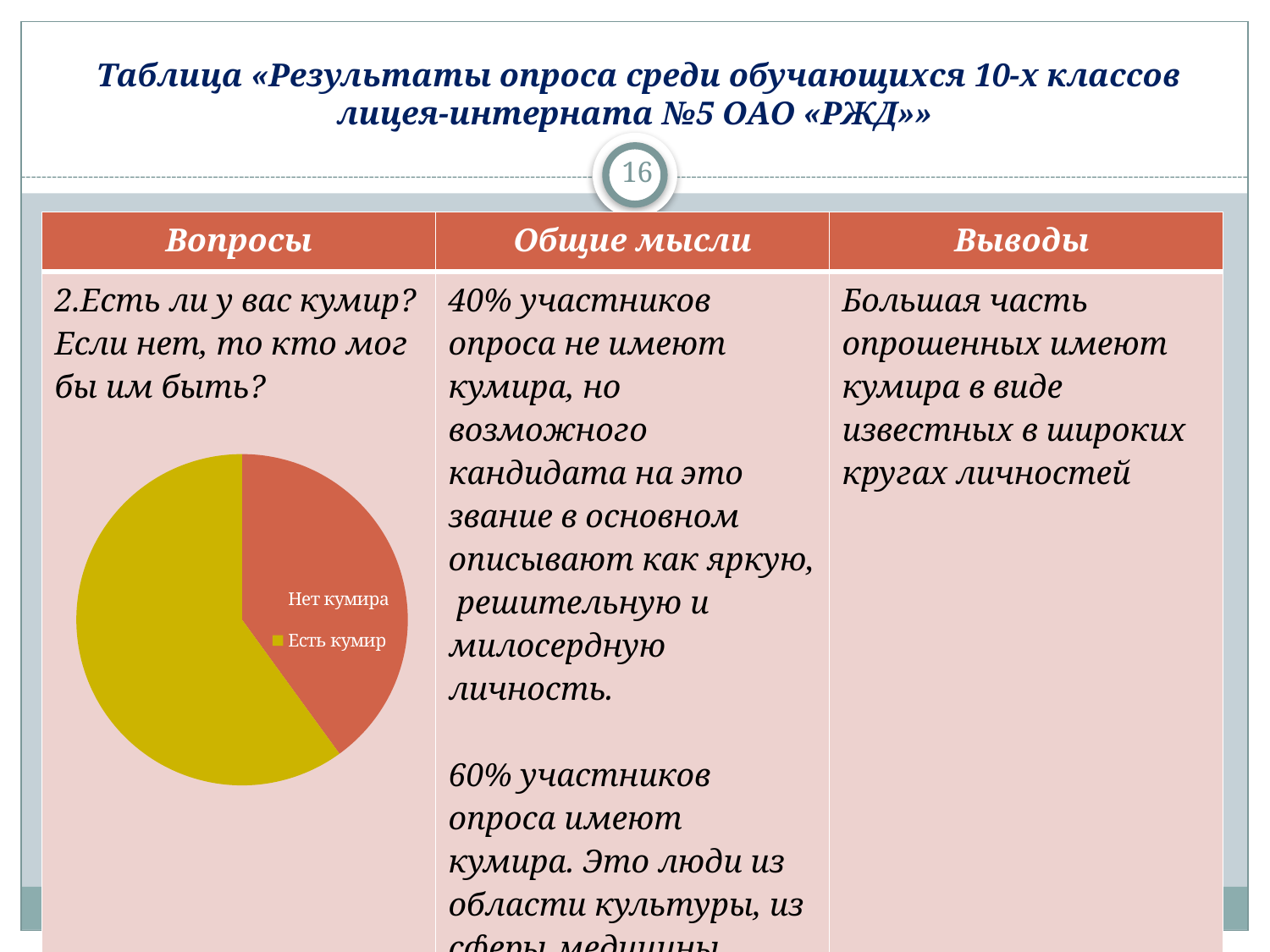
How many entries does the pie chart's legend list? 2 What colour is the "Есть кумир" slice in the pie chart? yellow How many slices does the pie chart have? 2 What share of the pie does the "Есть кумир" slice represent, according to the slide? 60% What share of the pie does the "Нет кумира" slice represent, according to the slide? 40% Which slice of the pie chart is the smallest? Нет кумира Which slice of the pie chart is the largest? Есть кумир What are the two legend entries of the pie chart? Нет кумира, Есть кумир Which slice is larger in the pie chart, "Есть кумир" or "Нет кумира"? Есть кумир What kind of chart is shown on the slide? pie chart